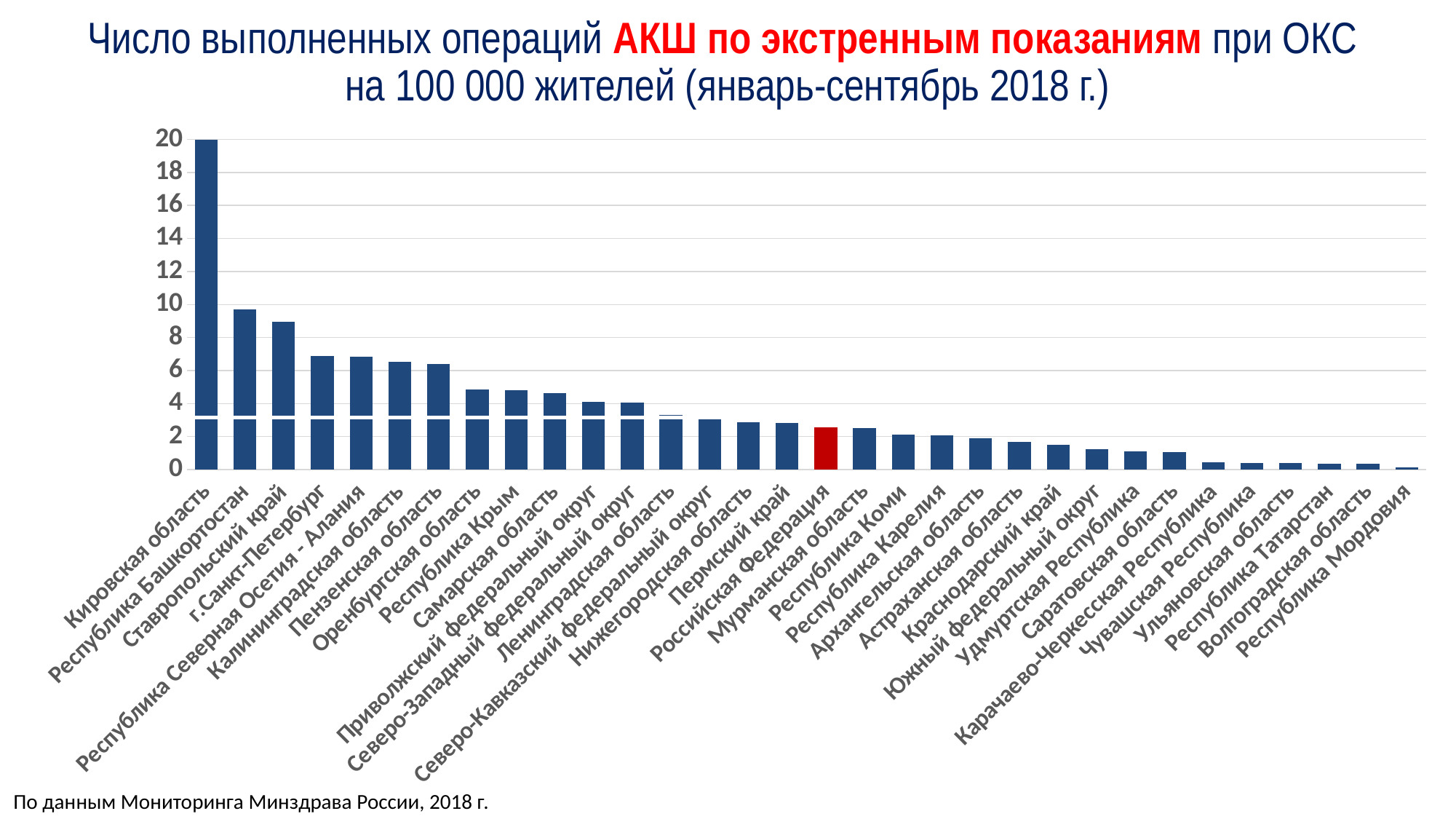
Is the value for Кировская область greater or less than 10? greater Is the value for г.Санкт-Петербург greater or less than 6? greater What kind of chart is shown on the slide? bar chart Which region has the lowest value on the chart? Республика Мордовия Which category's bar is highlighted in red? Российская Федерация Is the value for Республика Мордовия greater or less than 2? less Do the values rise or fall moving from left to right along the x axis? fall Which has a larger value: Кировская область or Республика Башкортостан? Кировская область Which region has the highest value on the chart? Кировская область How many regions (categories) are plotted on the chart? 32